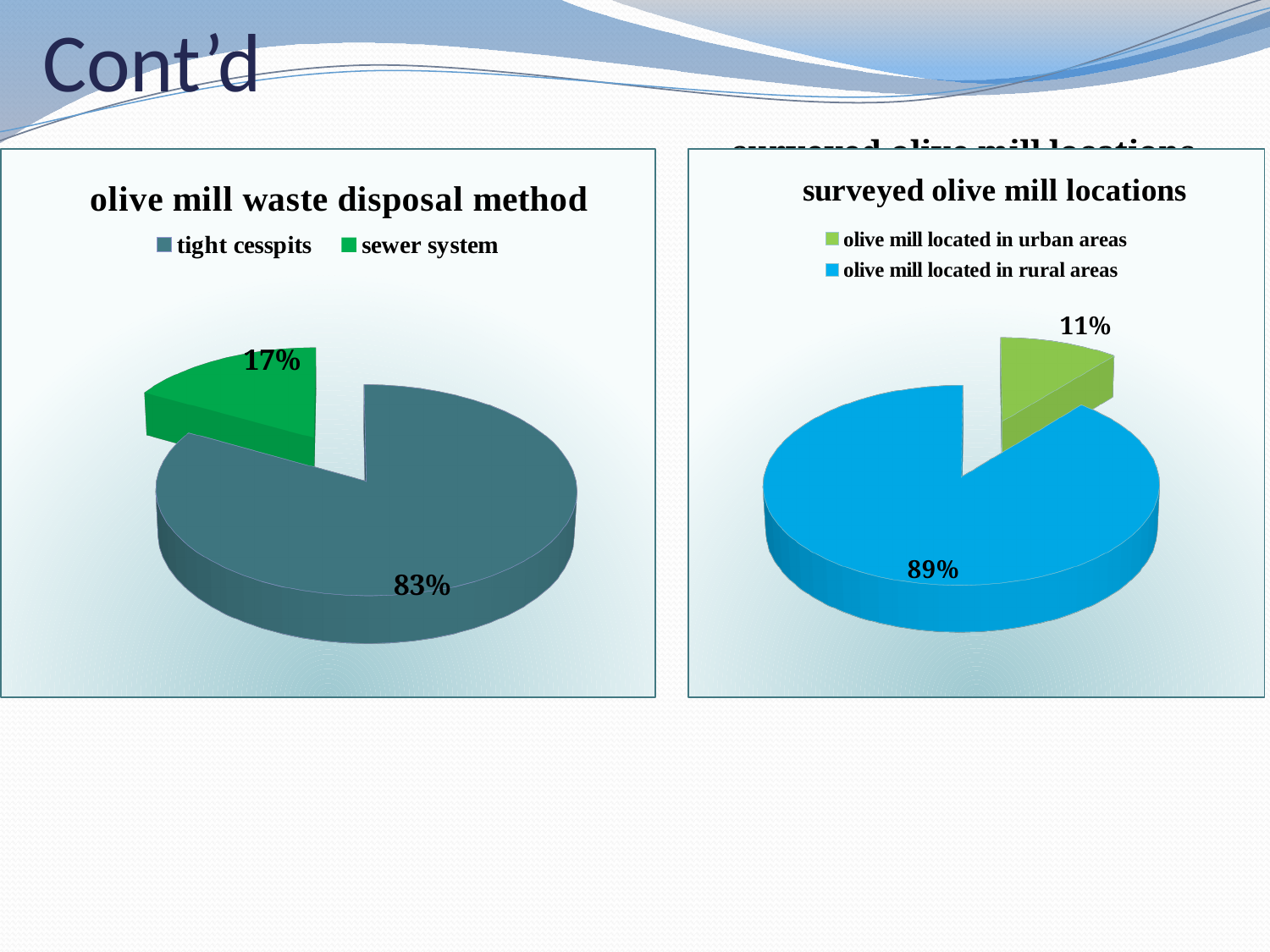
What type of chart is the 'olive mill waste disposal method' chart? pie chart In the 'surveyed olive mill locations' chart, which category has the smallest share? olive mill located in urban areas In the 'surveyed olive mill locations' chart, which is larger: the share for urban areas or the share for rural areas? olive mill located in rural areas In the 'olive mill waste disposal method' chart, what percentage is shown for tight cesspits? 83% In the 'surveyed olive mill locations' chart, what percentage of olive mills are located in urban areas? 11% In the 'olive mill waste disposal method' chart, what is the difference in percentage points between tight cesspits and sewer system? 66 In the 'surveyed olive mill locations' chart, what is the difference in percentage points between rural and urban areas? 78 In the 'olive mill waste disposal method' chart, what percentage is shown for sewer system? 17% How many categories does the legend of the 'surveyed olive mill locations' chart list? 2 In the 'surveyed olive mill locations' chart, what percentage of olive mills are located in rural areas? 89% In the 'olive mill waste disposal method' chart, which category has the largest share? tight cesspits In the 'olive mill waste disposal method' chart, what colour is the sewer system slice? green